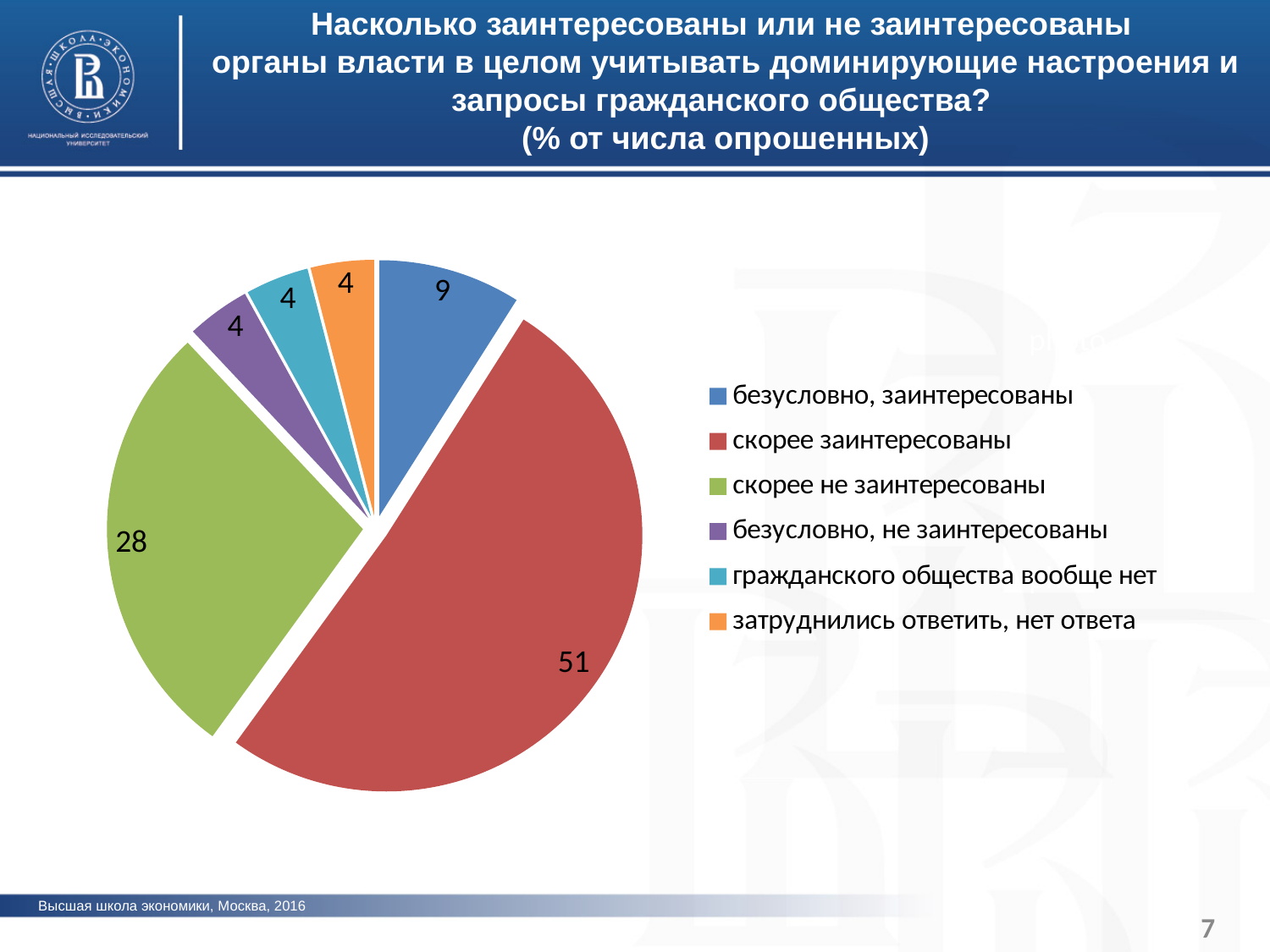
How many slices does the pie chart have? 6 What is the value for "гражданского общества вообще нет"? 4 What colour is the slice for "затруднились ответить, нет ответа"? orange What is the smallest value shown on the pie chart? 4 What is the value for "безусловно, заинтересованы"? 9 What is the difference between the values for "скорее заинтересованы" and "скорее не заинтересованы"? 23 What is the value for "скорее не заинтересованы"? 28 What type of chart is shown on the slide? pie chart How many entries does the legend list? 6 What is the value for "скорее заинтересованы"? 51 Which is larger: the value for "безусловно, заинтересованы" or the value for "безусловно, не заинтересованы"? безусловно, заинтересованы Which category has the largest slice of the pie? скорее заинтересованы